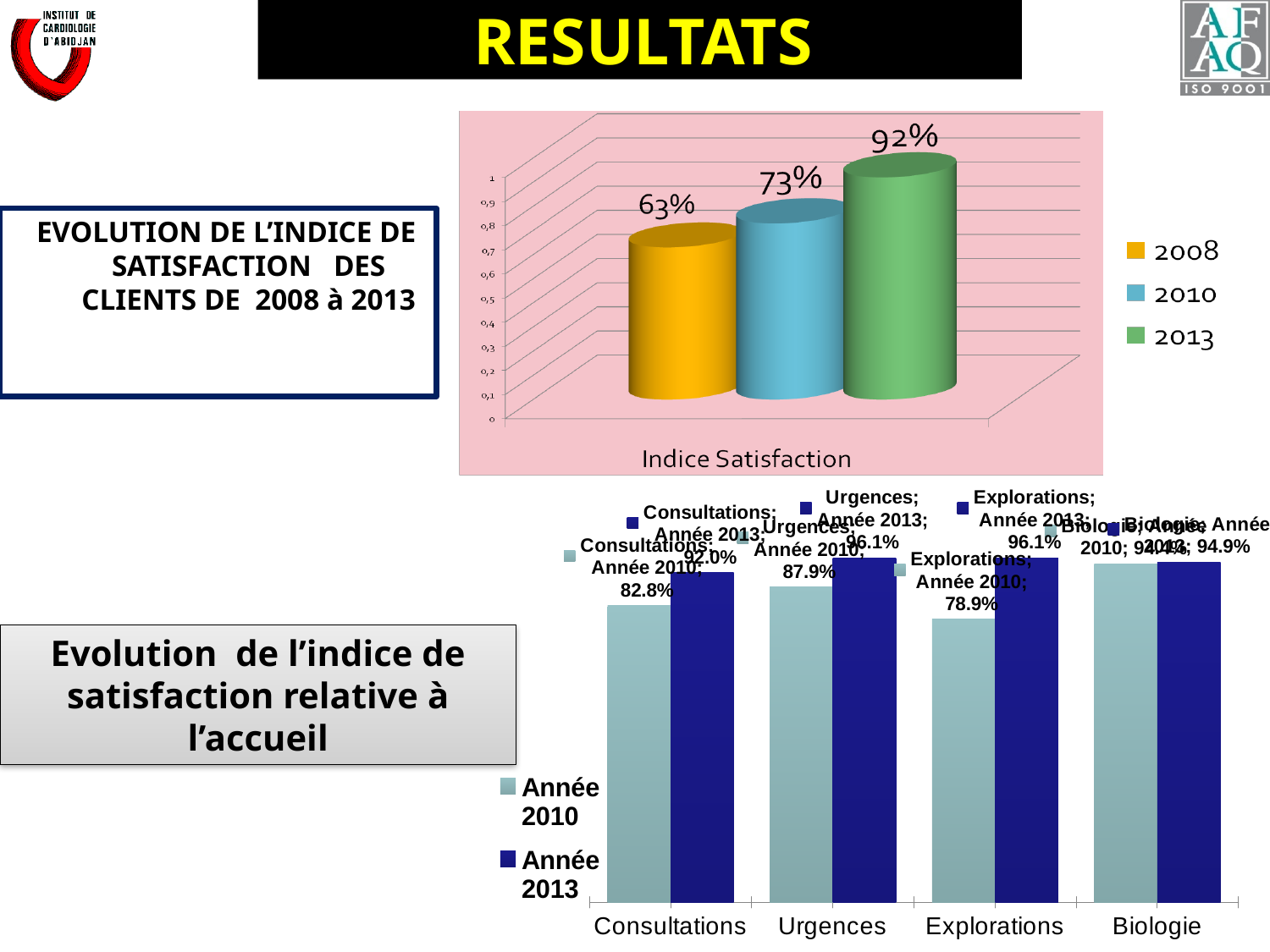
In the top chart (Indice Satisfaction), how many entries does the legend list? 3 In the top chart (Indice Satisfaction), what is the value for 2013? 92% In the bottom chart (satisfaction relative à l'accueil), what is the value for Consultations in Année 2010? 82.8% In the top chart (Indice Satisfaction), which year has the lowest satisfaction index? 2008 In the top chart (Indice Satisfaction), what is the value for 2008? 63% In the top chart (Indice Satisfaction), do the values rise or fall from 2008 to 2013? rise In the bottom chart (satisfaction relative à l'accueil), which is larger for Urgences: Année 2010 or Année 2013? Année 2013 In the bottom chart (satisfaction relative à l'accueil), what is the value for Explorations in Année 2013? 96.1% In the bottom chart (satisfaction relative à l'accueil), how many categories are shown on the x axis? 4 In the bottom chart (satisfaction relative à l'accueil), what is the difference between Année 2013 and Année 2010 for Explorations? 17.2% In the top chart (Indice Satisfaction), which year has the highest satisfaction index? 2013 In the top chart (Indice Satisfaction), what is the difference between the 2013 and 2010 values? 19%